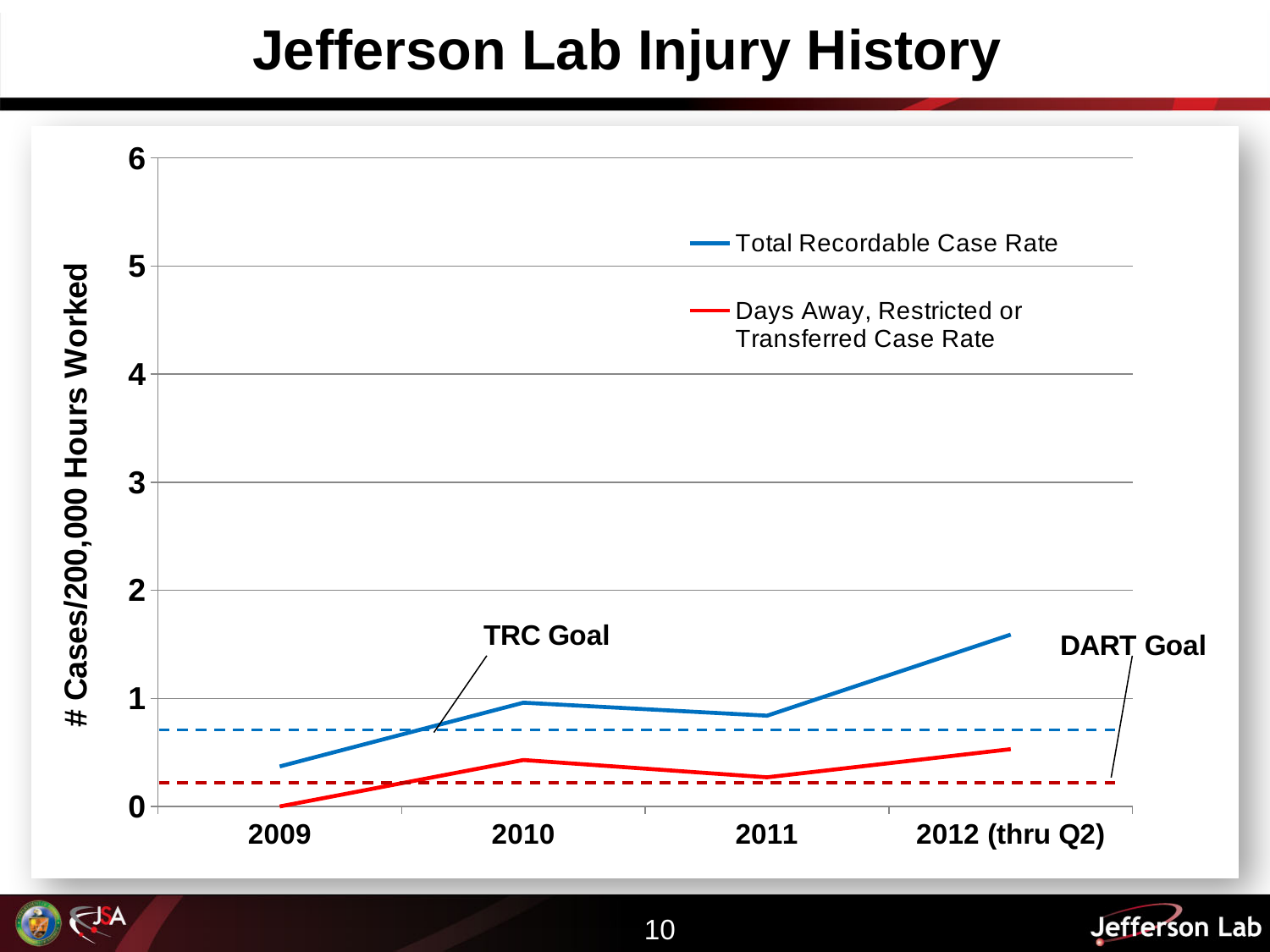
In which year is the Days Away, Restricted or Transferred Case Rate lowest? 2009 In which year is the Total Recordable Case Rate lowest? 2009 Is the Total Recordable Case Rate for 2009 greater or less than 1? less What kind of chart is shown on the slide? line chart Is the Total Recordable Case Rate for 2012 (thru Q2) greater or less than 1? greater What is the Days Away, Restricted or Transferred Case Rate for 2009? 0 Does the Total Recordable Case Rate rise or fall from 2011 to 2012 (thru Q2)? rise How many series does the legend list? 2 Which is larger in 2012 (thru Q2): the Total Recordable Case Rate or the Days Away, Restricted or Transferred Case Rate? Total Recordable Case Rate In which year is the Total Recordable Case Rate highest? 2012 (thru Q2) How many years (categories) are shown on the x axis? 4 In which year is the Days Away, Restricted or Transferred Case Rate highest? 2012 (thru Q2)